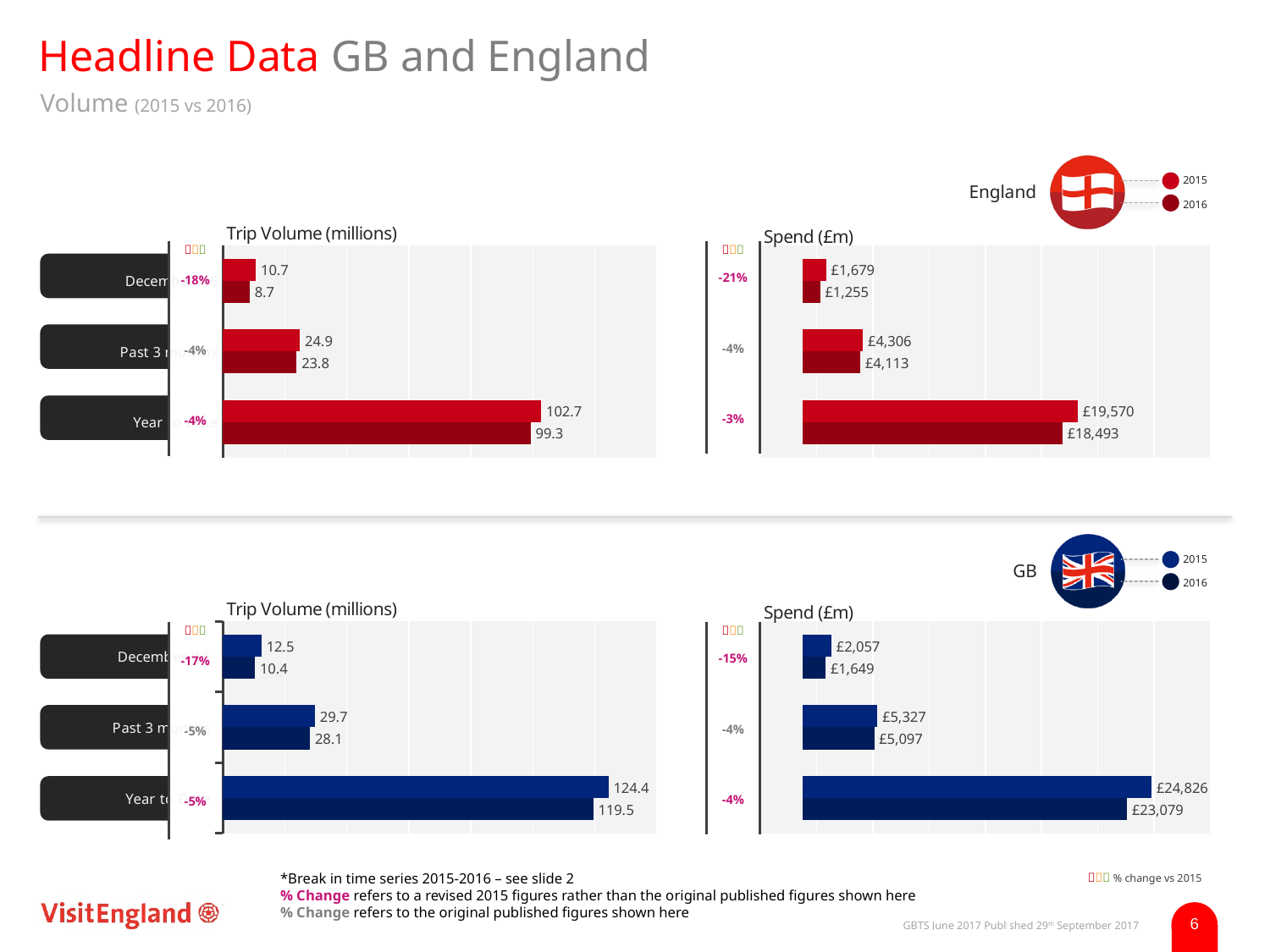
In the GB Trip Volume (millions) chart, which row has the highest 2015 value? Year What percentage change is shown next to the December row in the GB Spend (£m) chart? -15% What type of chart is the England Spend (£m) chart? bar chart How many series does the legend list for the GB charts? 2 In the England Trip Volume (millions) chart, is the 2015 value for December larger or smaller than the 2016 value for December? larger In the GB Spend (£m) chart, what is the 2016 value for the Past 3 months row? £5,097 In the England Trip Volume (millions) chart, what is the difference between the 2015 and 2016 values for the Past 3 months row? 1.1 In the GB Trip Volume (millions) chart, what is the 2015 value for the December row? 12.5 In the England Trip Volume (millions) chart, what is the 2016 value for the Year row? 99.3 In the GB Spend (£m) chart, what is the difference between the 2015 and 2016 values for the Year row? £1,747 In the England Spend (£m) chart, which row has the lowest 2016 value? December In the England Spend (£m) chart, what is the 2015 value for the Year row? £19,570